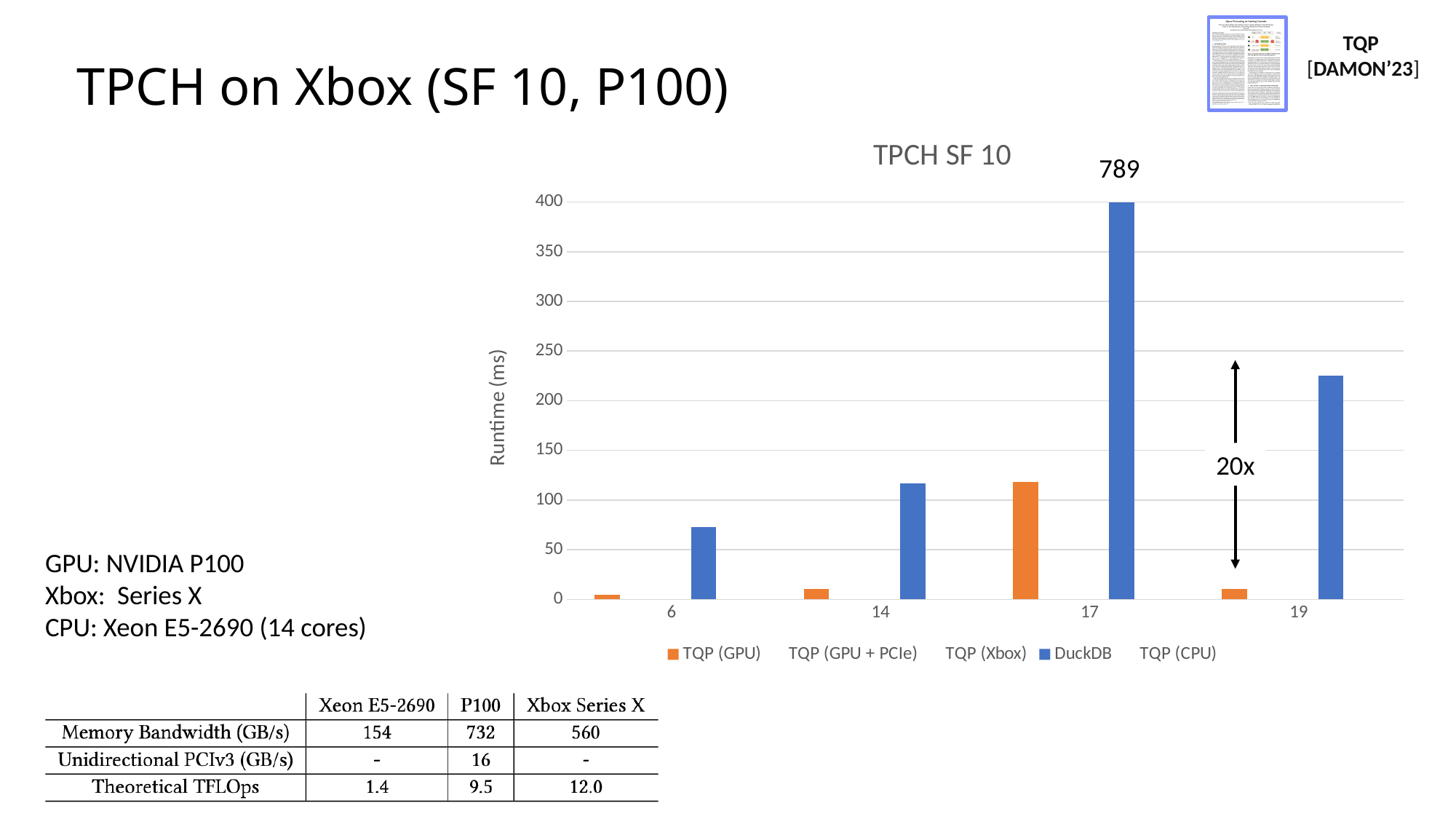
How many query categories are shown on the x axis of the chart? 4 What is the title of the chart? TPCH SF 10 For which query is the DuckDB bar the lowest? 6 Is the TQP (GPU) value for query 6 greater or less than 50? less For which query is the DuckDB bar the highest? 17 For query 17, which is larger: the DuckDB bar or the TQP (GPU) bar? DuckDB What type of chart is shown on the slide? bar chart Is the DuckDB value for query 19 greater or less than 200? greater What is the label of the y axis of the chart? Runtime (ms) Is the TQP (GPU) value for query 17 greater or less than 100? greater What is the DuckDB runtime for query 17 according to the data label? 789